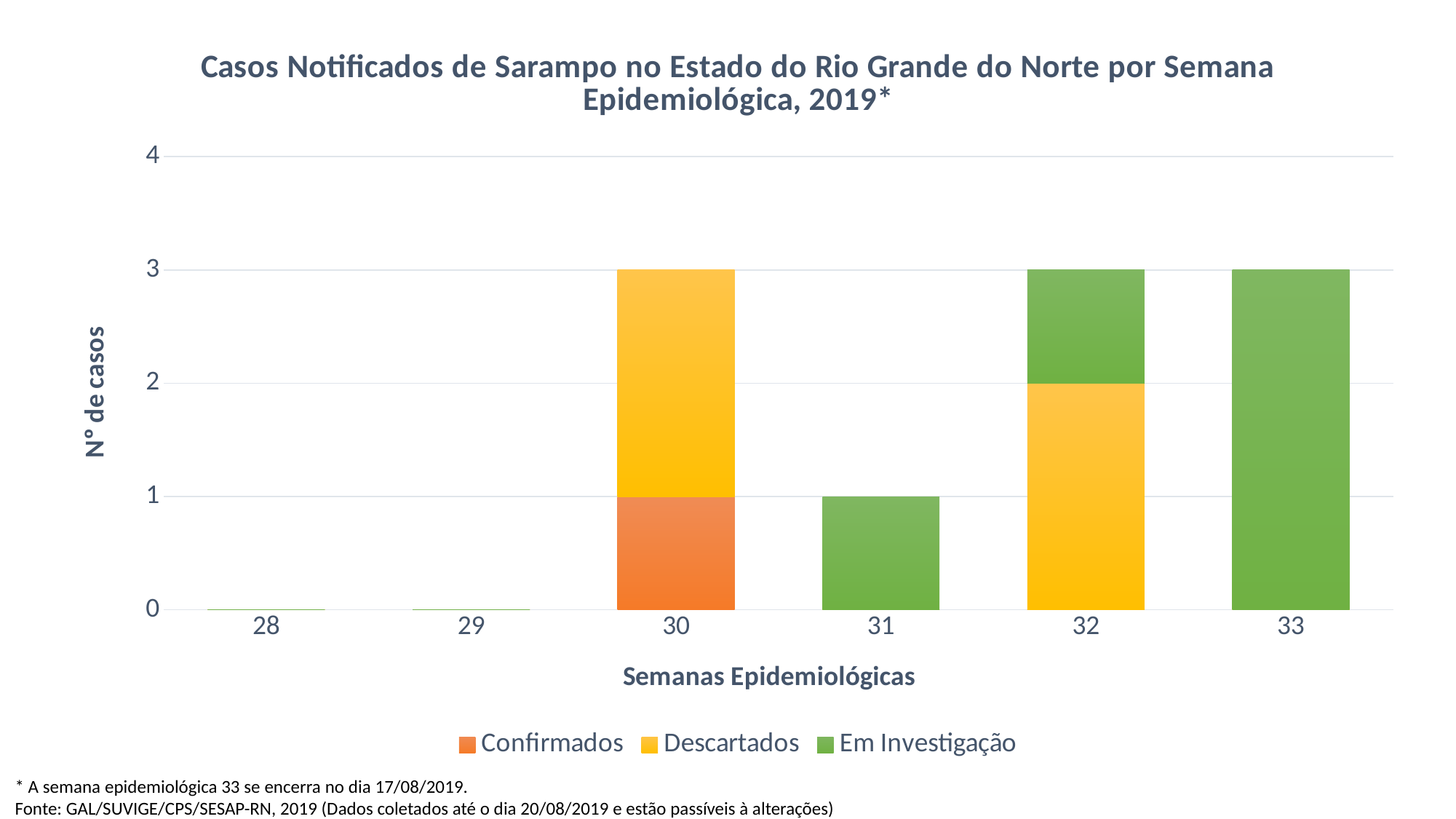
How many cases are 'Descartados' in week 32? 2 How many cases are 'Confirmados' in week 30? 1 How many cases are 'Em Investigação' in week 31? 1 How many cases are 'Em Investigação' in week 33? 3 Which week has the lowest total number of cases, week 29 or week 31? 29 What is the difference between the total cases in week 33 and week 31? 2 What is the total number of cases notified in week 32? 3 How many series does the legend list? 3 How many epidemiological weeks are shown on the x axis? 6 What kind of chart is shown on the slide? Stacked bar chart What is the total number of cases notified in week 30? 3 Which series is shown in orange in the legend? Confirmados